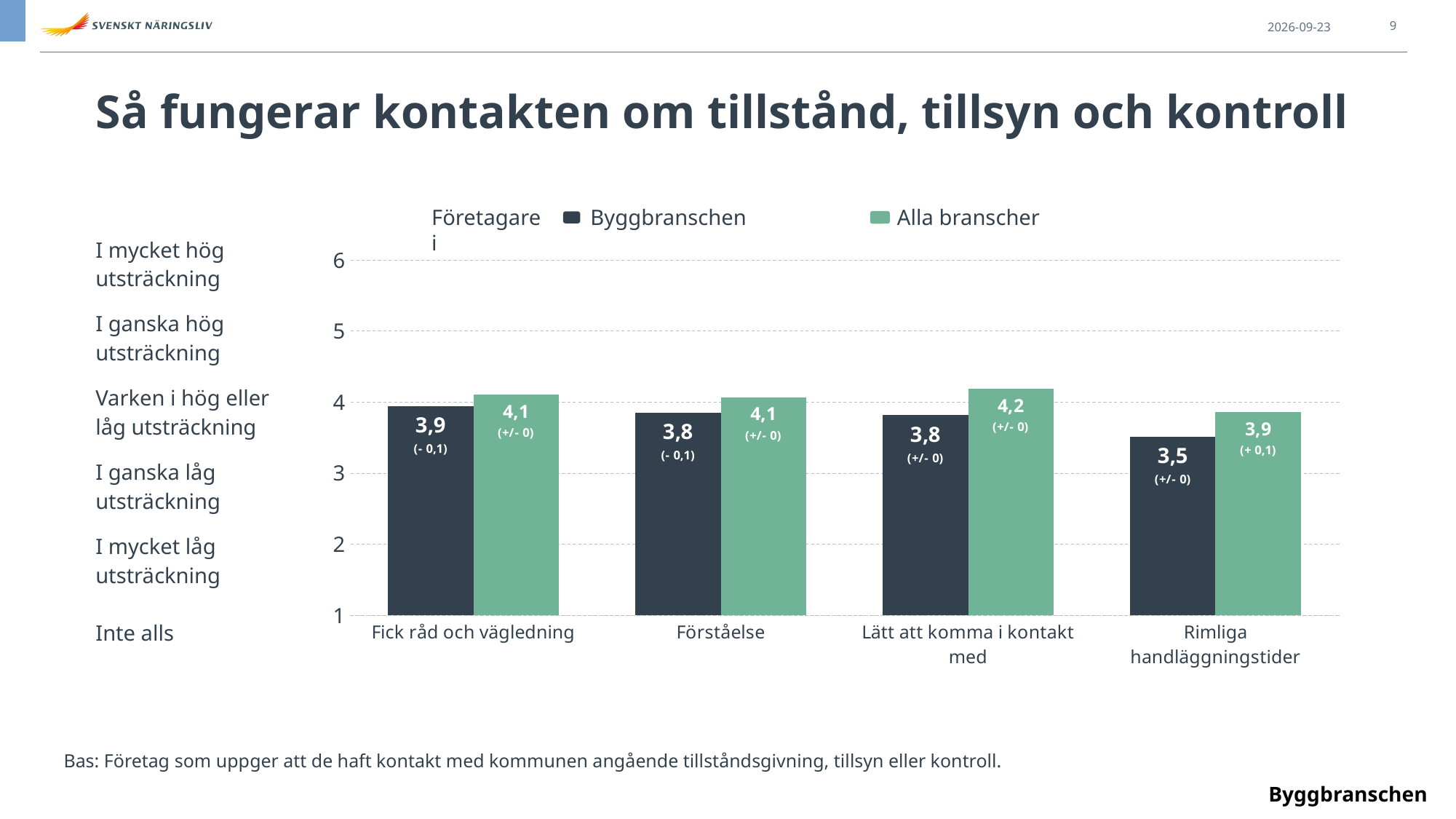
Which category has the lowest Byggbranschen value? Rimliga handläggningstider What kind of chart is shown on the slide? Bar chart How many series does the legend list? 2 What is the difference between the Alla branscher and Byggbranschen values for Rimliga handläggningstider? 0,4 What is the Alla branscher value for Förståelse? 4,1 Is the Byggbranschen value for Lätt att komma i kontakt med greater or less than 4? less How many categories are shown on the x axis? 4 What is the Byggbranschen value for Rimliga handläggningstider? 3,5 Which category has the highest Alla branscher value? Lätt att komma i kontakt med What is the Alla branscher value for Lätt att komma i kontakt med? 4,2 For Förståelse, which series has the larger value, Byggbranschen or Alla branscher? Alla branscher What is the Byggbranschen value for Fick råd och vägledning? 3,9